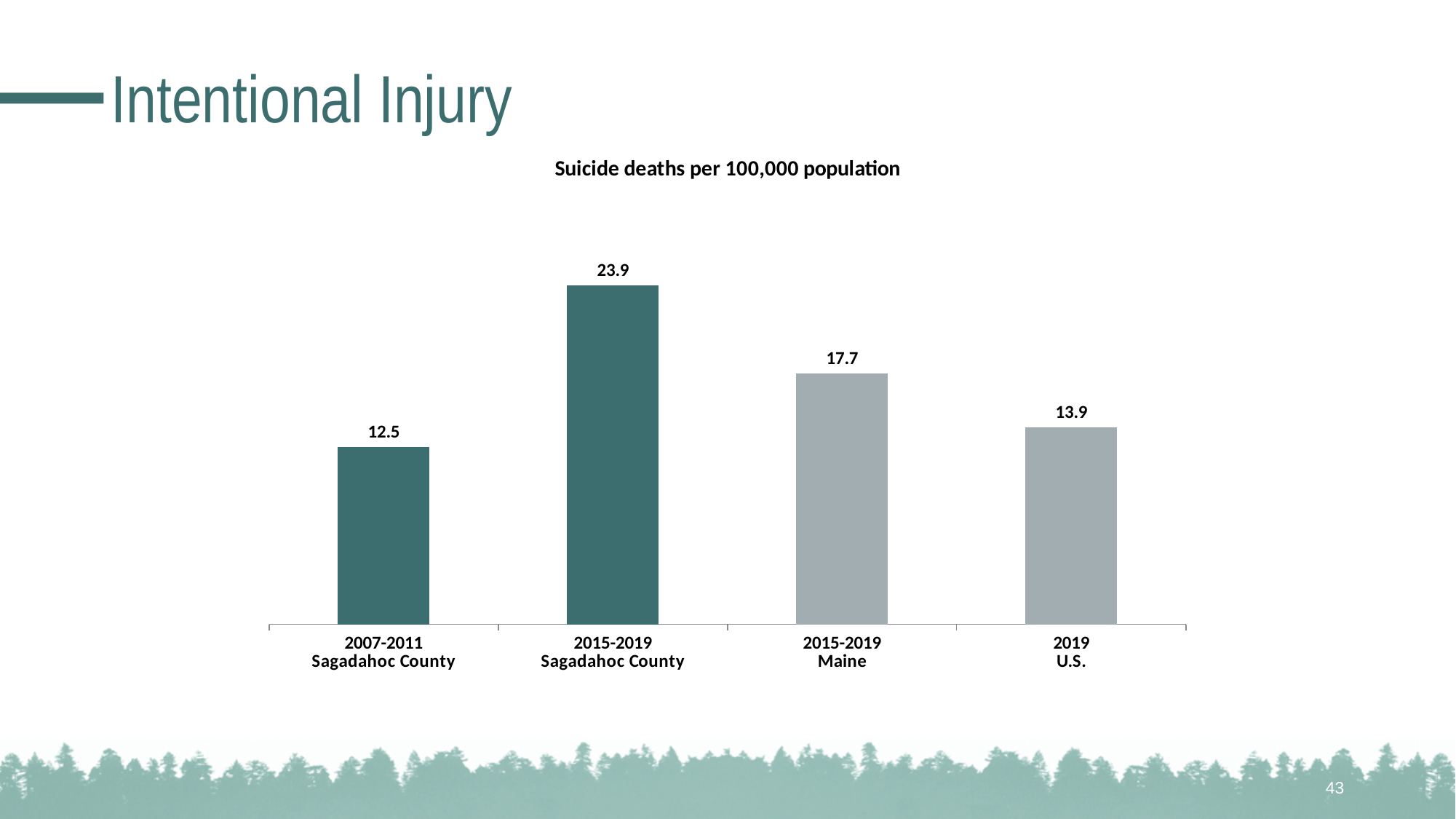
What is the suicide death rate per 100,000 population for Sagadahoc County in 2007-2011? 12.5 What is the difference between the Sagadahoc County suicide death rate in 2015-2019 and in 2007-2011? 11.4 Which category has the lowest suicide death rate? 2007-2011 Sagadahoc County Which is larger, the 2015-2019 Maine rate or the 2019 U.S. rate? 2015-2019 Maine What is the title of the chart? Suicide deaths per 100,000 population What is the suicide death rate per 100,000 population for Maine in 2015-2019? 17.7 Which category has the highest suicide death rate? 2015-2019 Sagadahoc County What is the difference between the 2015-2019 Sagadahoc County rate and the 2015-2019 Maine rate? 6.2 What type of chart is shown on the slide? Bar chart What is the suicide death rate per 100,000 population for the U.S. in 2019? 13.9 How many bars are shown in the chart? 4 What is the suicide death rate per 100,000 population for Sagadahoc County in 2015-2019? 23.9